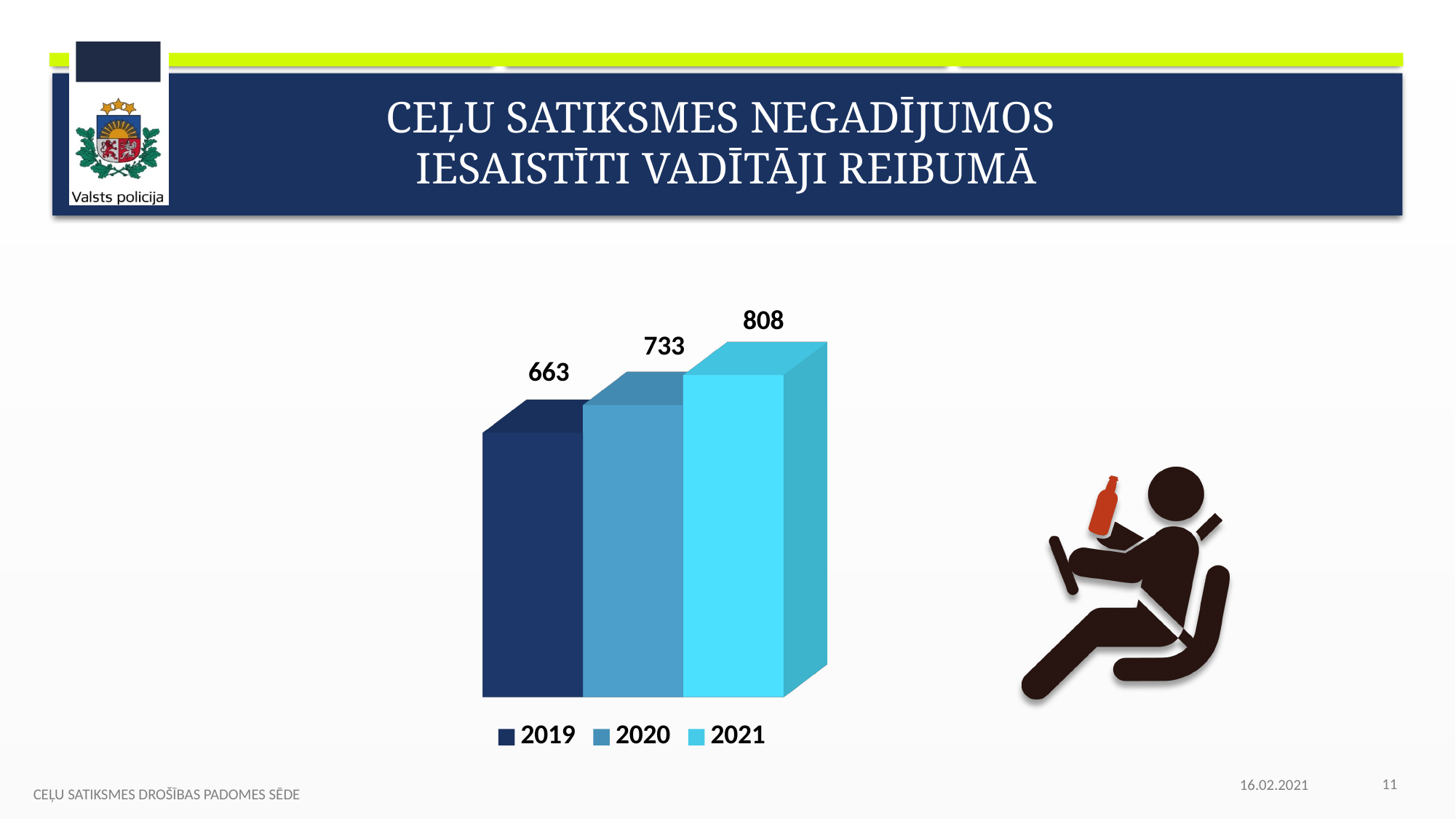
Do the values rise or fall from 2019 to 2021? rise What is the difference between the values for 2020 and 2019? 70 What is the value for 2021? 808 What is the value for 2020? 733 How many series does the legend list? 3 What kind of chart is shown on the slide? bar chart Which colour represents 2021 in the legend? light blue Which year has the highest value? 2021 Which is larger, the value for 2020 or the value for 2021? 2021 Which year has the lowest value? 2019 What is the difference between the values for 2021 and 2019? 145 What is the value for 2019? 663